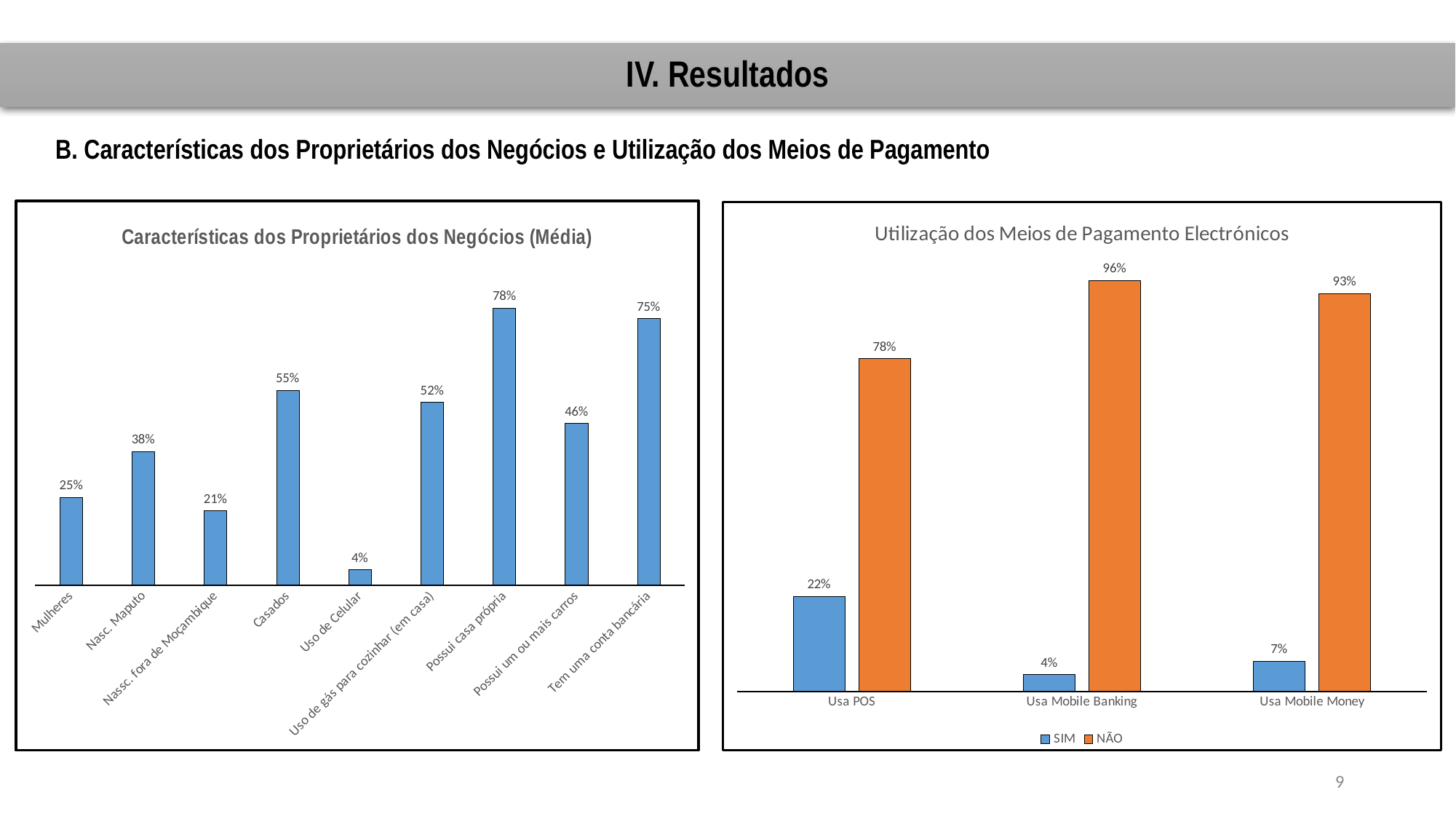
In the chart 'Características dos Proprietários dos Negócios (Média)', what is the value for Casados? 55% In the chart 'Utilização dos Meios de Pagamento Electrónicos', what is the SIM value for Usa POS? 22% In the chart 'Características dos Proprietários dos Negócios (Média)', how many categories are shown? 9 In the chart 'Características dos Proprietários dos Negócios (Média)', what is the value for Uso de Celular? 4% In the chart 'Características dos Proprietários dos Negócios (Média)', which category has the lowest value? Uso de Celular In the chart 'Utilização dos Meios de Pagamento Electrónicos', which category has the highest SIM value? Usa POS In the chart 'Características dos Proprietários dos Negócios (Média)', which category has the highest value? Possui casa própria In the chart 'Utilização dos Meios de Pagamento Electrónicos', what is the NÃO value for Usa Mobile Banking? 96% In the chart 'Utilização dos Meios de Pagamento Electrónicos', what is the difference between the NÃO and SIM values for Usa Mobile Money? 86% In the chart 'Utilização dos Meios de Pagamento Electrónicos', how many series does the legend list? 2 In the chart 'Características dos Proprietários dos Negócios (Média)', what is the difference between Tem uma conta bancária and Mulheres? 50% What type of chart is 'Utilização dos Meios de Pagamento Electrónicos'? Bar chart